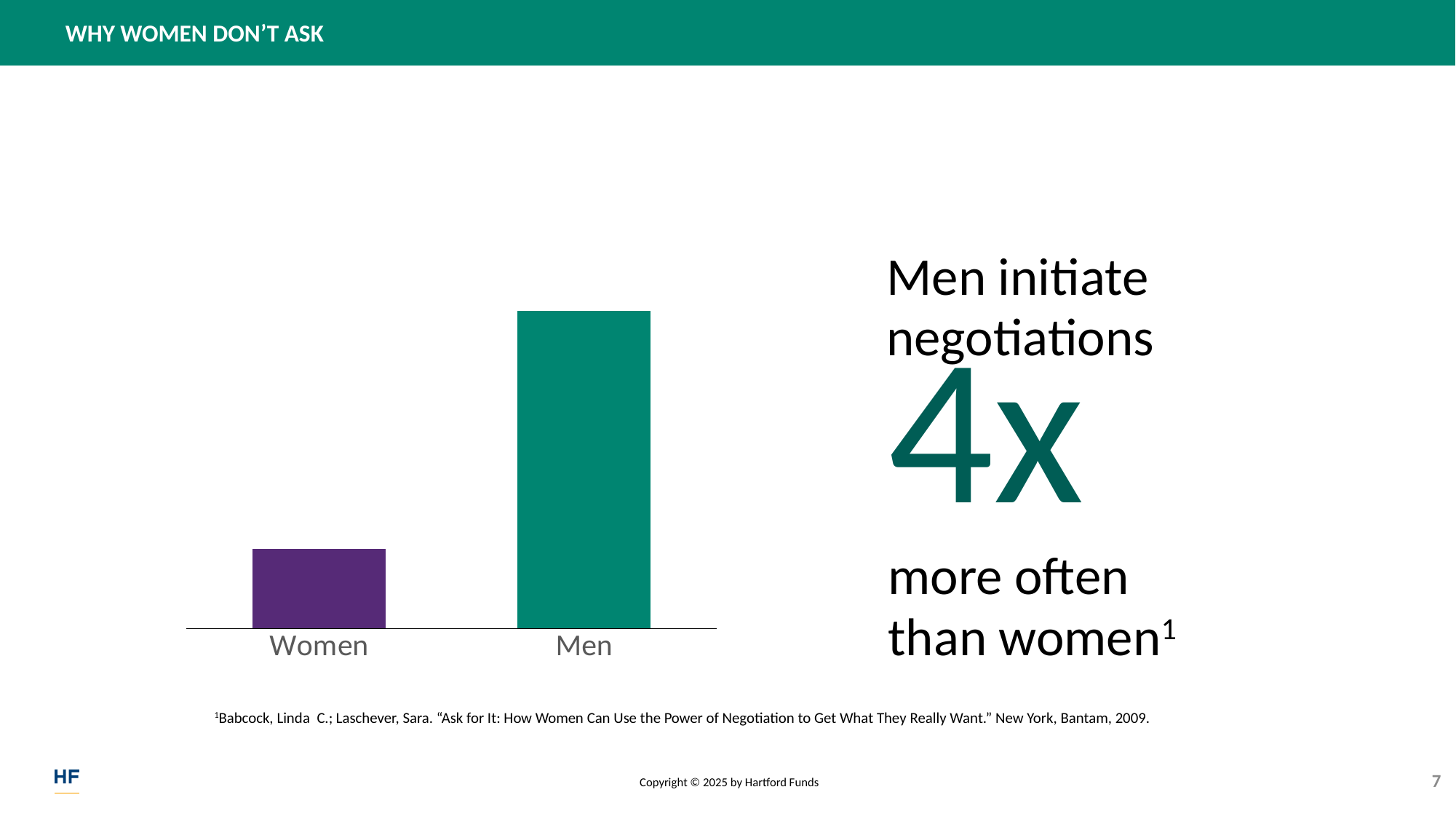
Is the bar for Men taller or shorter than the bar for Women? taller What colour is the bar for Women? purple What kind of chart is shown on the slide? bar chart What colour is the bar for Men? green Which category has the tallest bar in the chart? Men Which category has the shortest bar in the chart? Women How many categories does the bar chart show? 2 Which of the two bars, Women or Men, is larger? Men